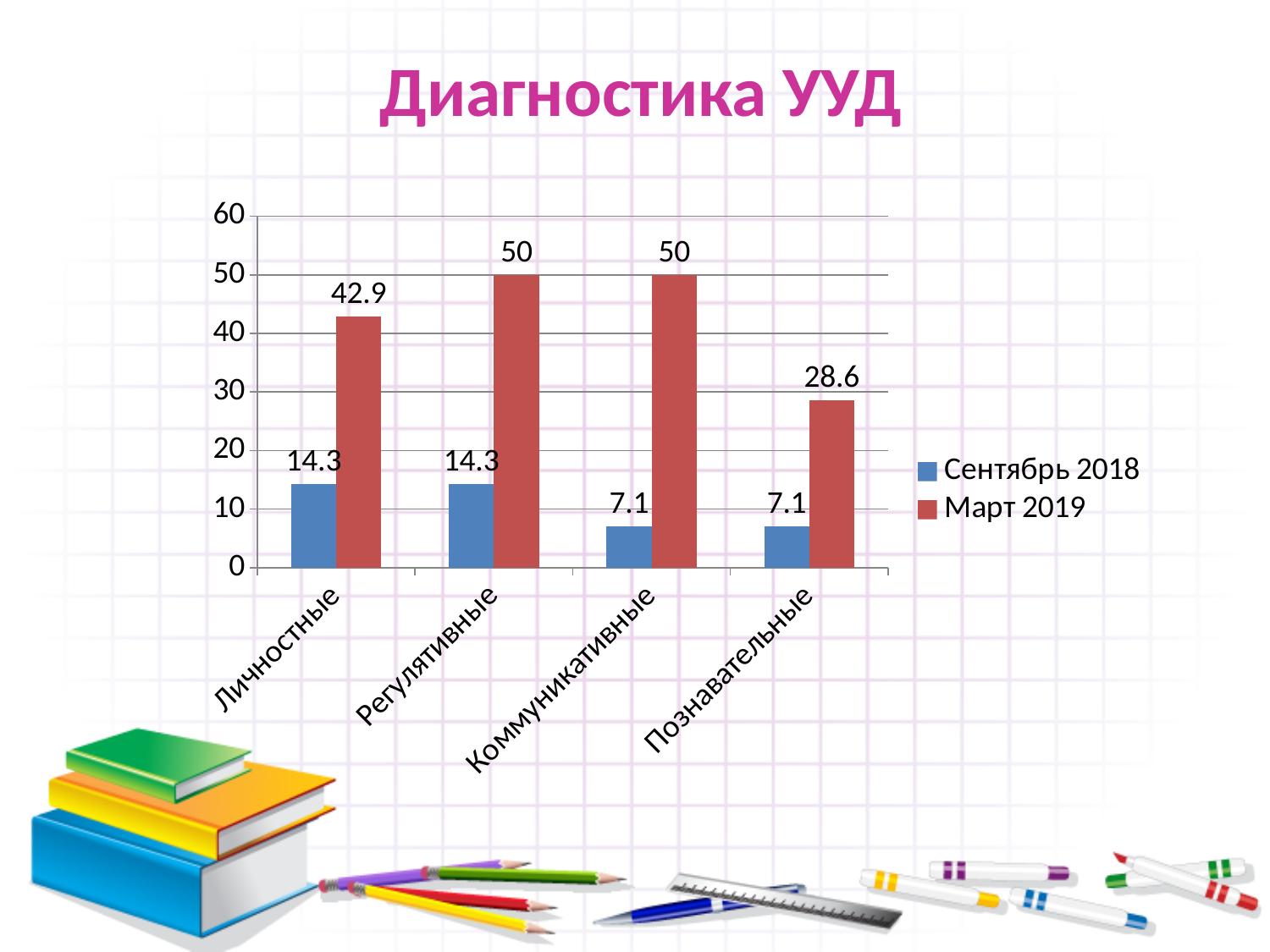
What is the difference between the Март 2019 and Сентябрь 2018 values for Личностные? 28.6 What is the title of the chart? Диагностика УУД What is the difference between the Март 2019 and Сентябрь 2018 values for Коммуникативные? 42.9 What is the value for Познавательные in the Март 2019 series? 28.6 Is the Март 2019 value for Личностные greater or less than 40? greater Which category has the lowest value in the Март 2019 series? Познавательные How many series does the legend list? 2 What is the value for Личностные in the Сентябрь 2018 series? 14.3 What is the value for Коммуникативные in the Сентябрь 2018 series? 7.1 How many categories are shown on the x axis? 4 Which is larger: the Март 2019 value for Регулятивные or the Март 2019 value for Познавательные? Регулятивные What kind of chart is shown on the slide? bar chart